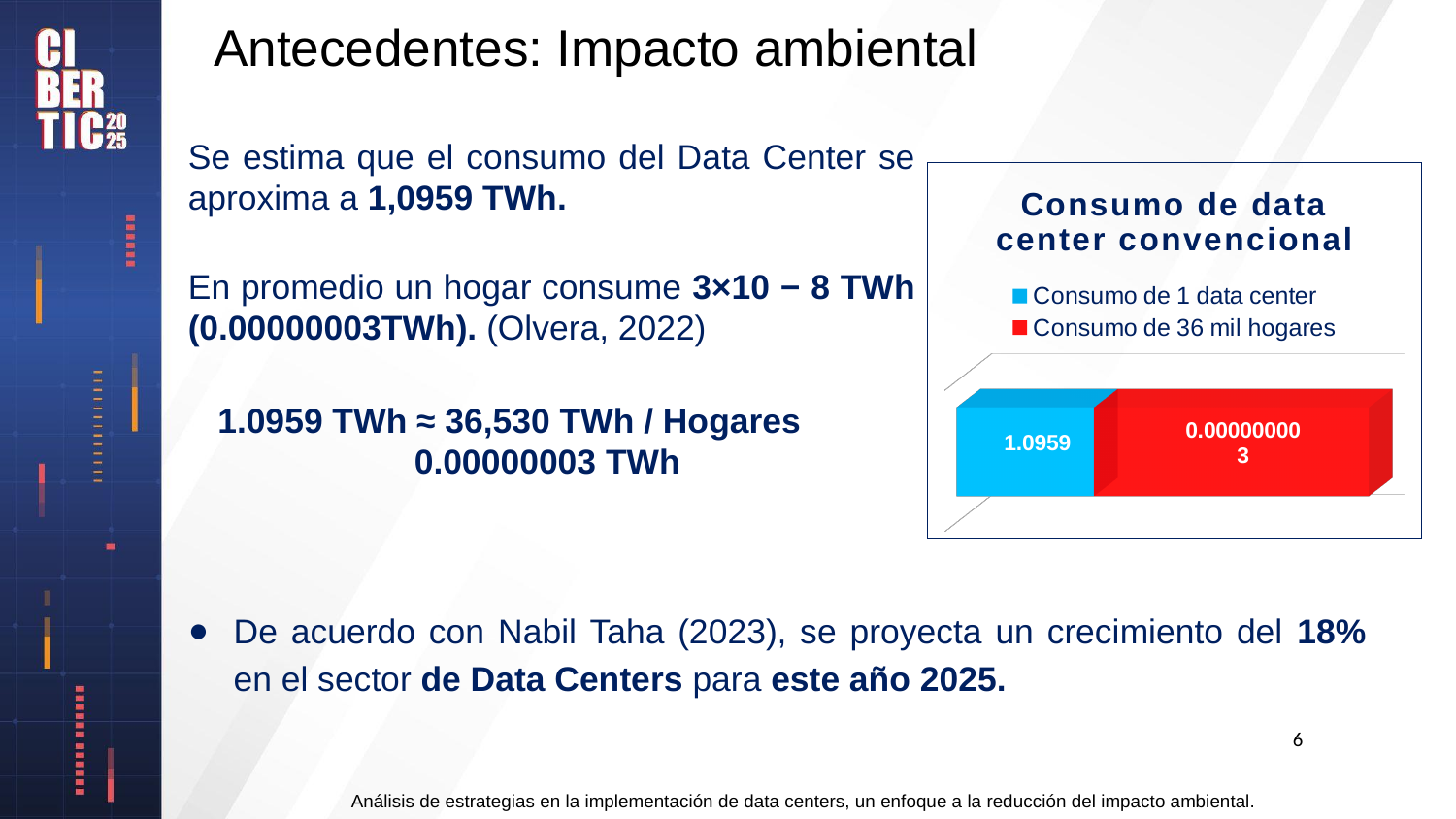
How many stacked bars are plotted in the chart? 1 What is the title of the chart on the slide? Consumo de data center convencional What kind of chart is shown on the slide? Bar chart How many series does the chart's legend list? 2 Which colour represents 'Consumo de 1 data center' in the chart's legend? Blue What value is labelled for the series 'Consumo de 36 mil hogares' in the chart? 0.000000003 Which series in the chart is shown in red? Consumo de 36 mil hogares What value is labelled for the series 'Consumo de 1 data center' in the chart? 1.0959 According to the data labels, which series has the larger value: 'Consumo de 1 data center' or 'Consumo de 36 mil hogares'? Consumo de 1 data center